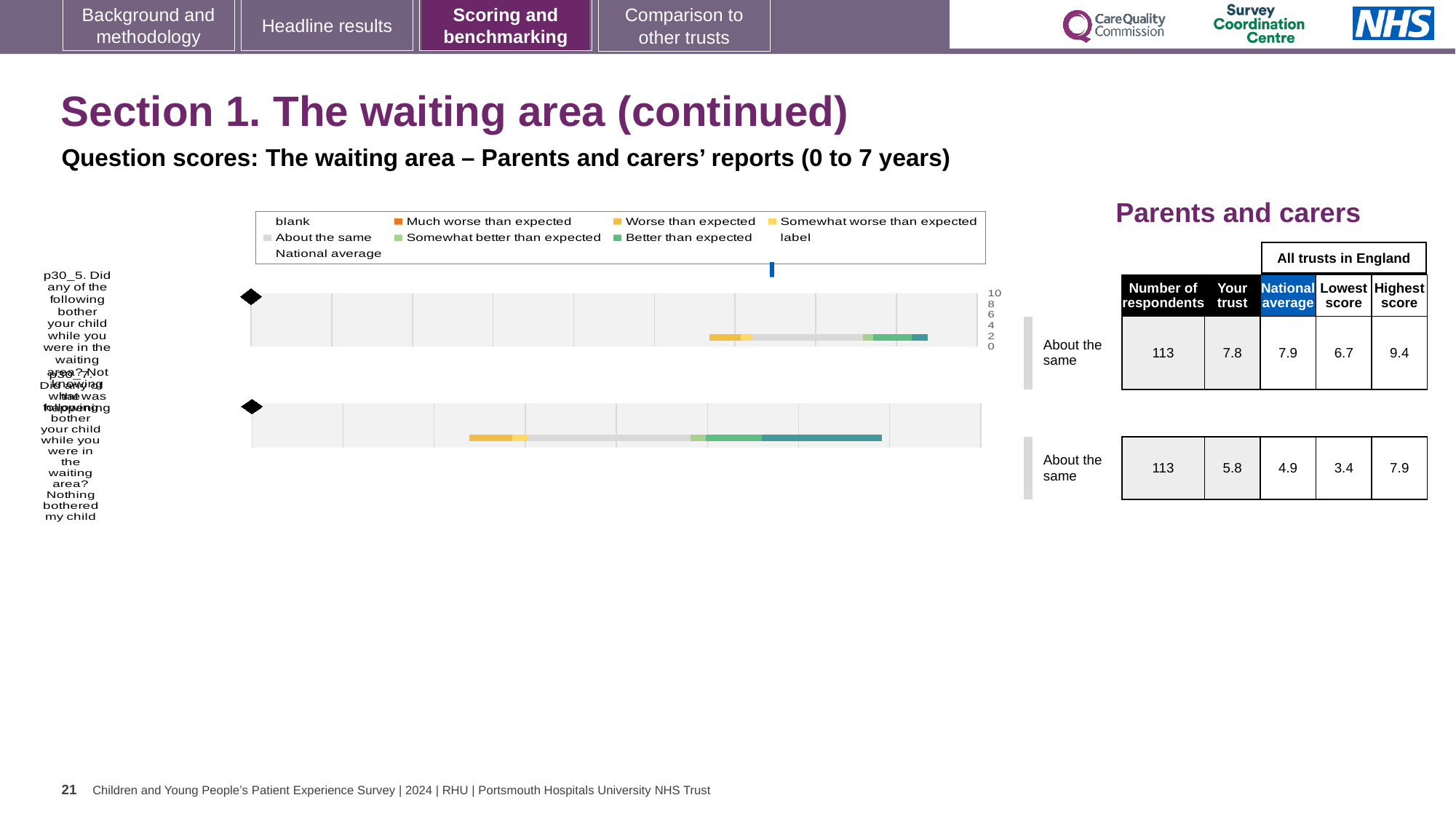
How many respondents answered question p30_5? 113 How many survey questions (bars) are plotted in the chart? 2 Is the 'Your trust' score for question p30_7 greater or less than 4? greater What colour represents 'Much worse than expected' in the chart legend? orange What kind of chart is shown on the slide? bar chart What is the difference between the 'Your trust' scores for p30_5 and p30_7? 2.0 For question p30_7, which is larger: the 'Your trust' score or the national average? Your trust What is the difference between the highest score and the lowest score for question p30_5? 2.7 What is the 'Your trust' score for question p30_5 (Not knowing what was happening)? 7.8 What is the highest value shown on the chart's score axis? 10 What is the national average score for question p30_7 (Nothing bothered my child)? 4.9 What benchmark category is given for question p30_5? About the same